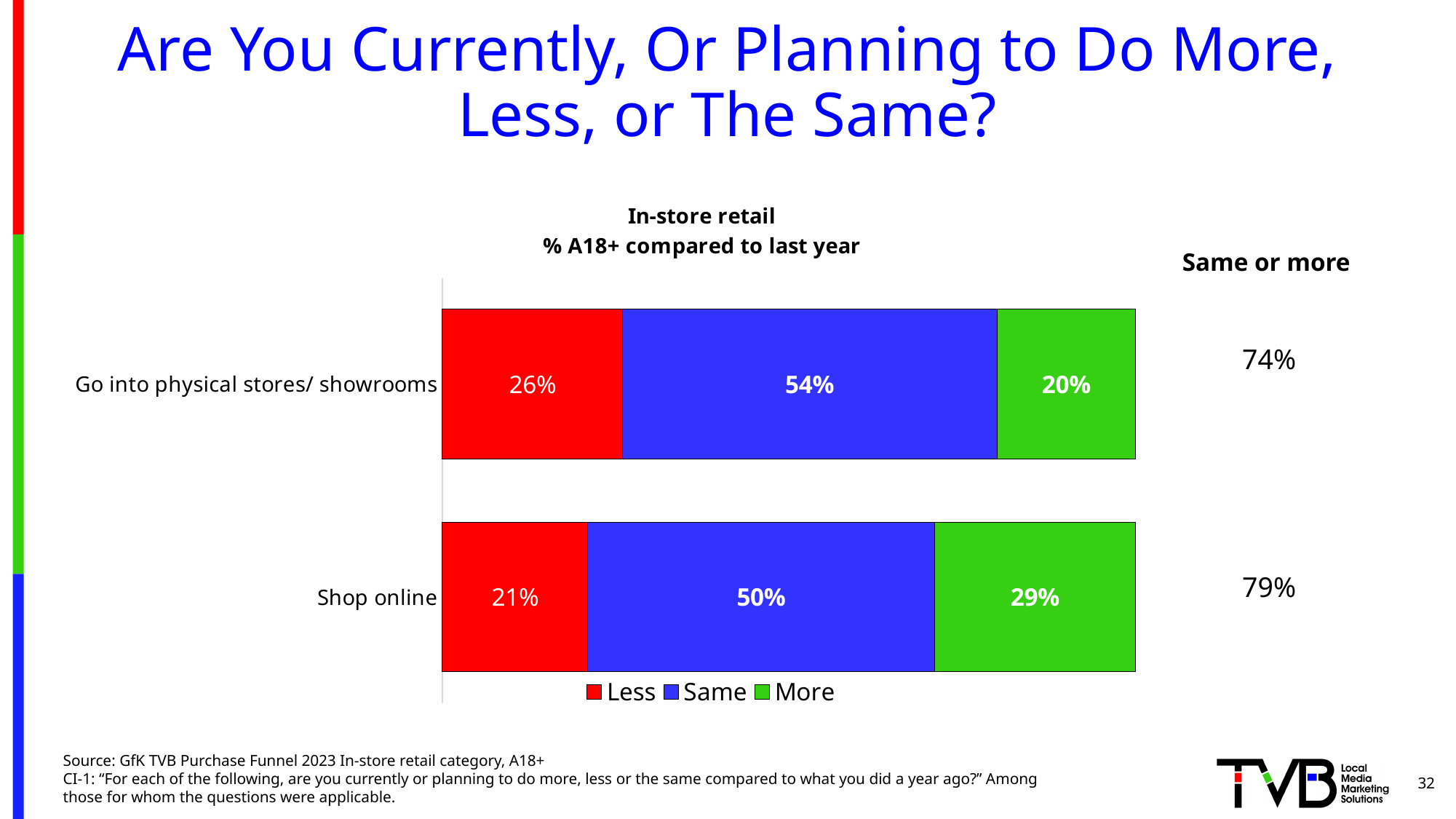
Which category has the higher 'More' percentage, Go into physical stores/ showrooms or Shop online? Shop online What percentage of A18+ say they are doing less going into physical stores/showrooms? 26% How many series does the legend list? 3 What is the difference between the 'Same' percentages for Go into physical stores/ showrooms and Shop online? 4% Which category has the higher 'Less' percentage? Go into physical stores/ showrooms What is the 'Same or more' figure shown for Go into physical stores/ showrooms? 74% What is the difference between the 'Same or more' figures for Shop online and Go into physical stores/ showrooms? 5% What percentage of A18+ say they are doing more shopping online? 29% What percentage of A18+ say they are doing the same amount of shopping online? 50% What type of chart is shown on the slide? Stacked bar chart Which colour represents the 'Same' series in the chart? Blue How many categories are shown in the chart? 2